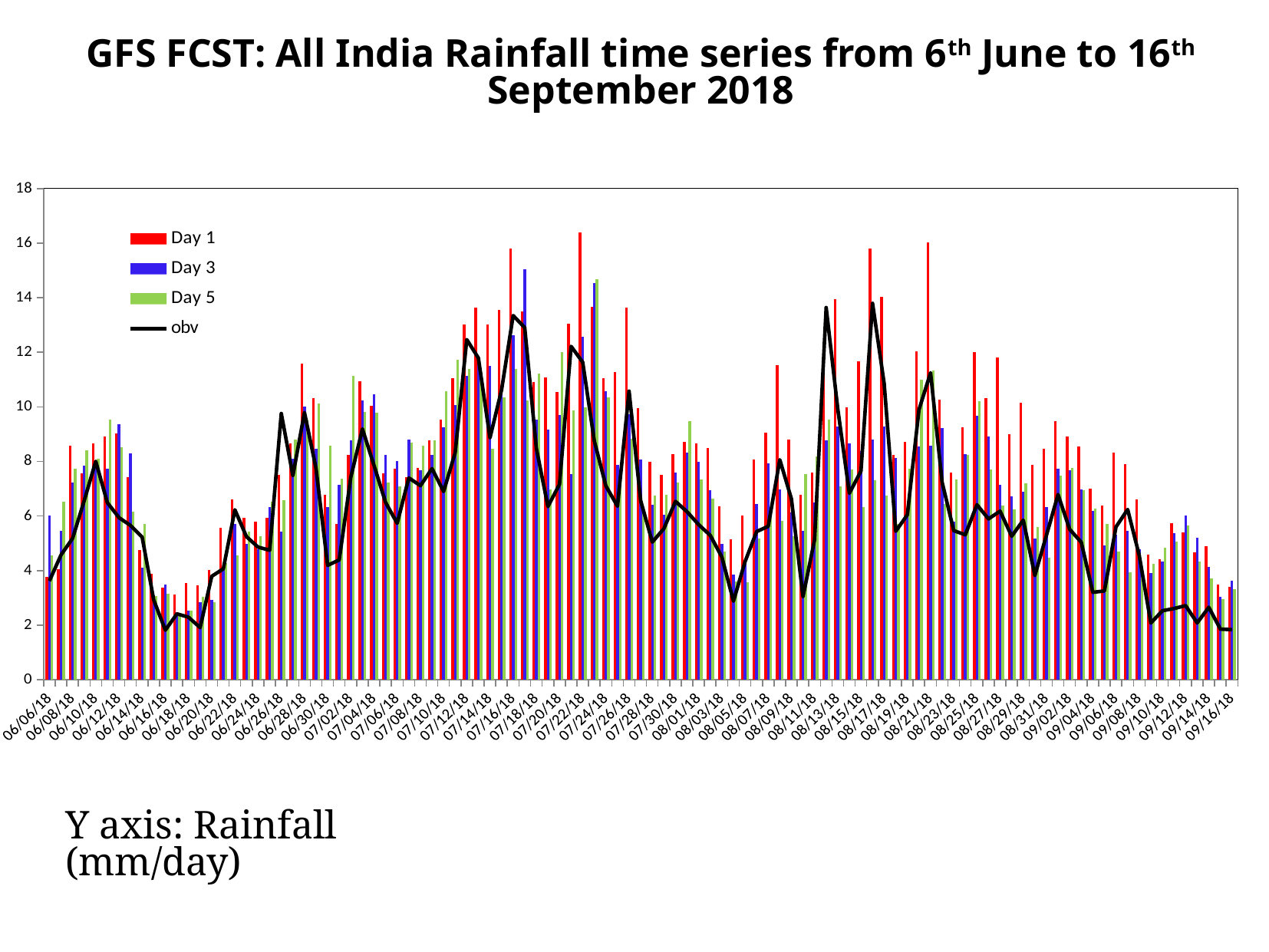
Is the obv value on 09/16/18 greater or less than 4? less Does the obv line rise or fall from 08/17/18 to 08/19/18? fall What is the title of the chart? GFS FCST: All India Rainfall time series from 6th June to 16th September 2018 Is the Day 1 value on 08/21/18 greater or less than 14? greater Is the obv value on 08/13/18 greater or less than 12? less Does the obv line rise or fall from 06/06/18 to 06/10/18? rise What kind of chart is shown on the slide? A bar chart combined with a line How many series does the legend list? 4 Which colour represents the Day 5 series in the legend? Green